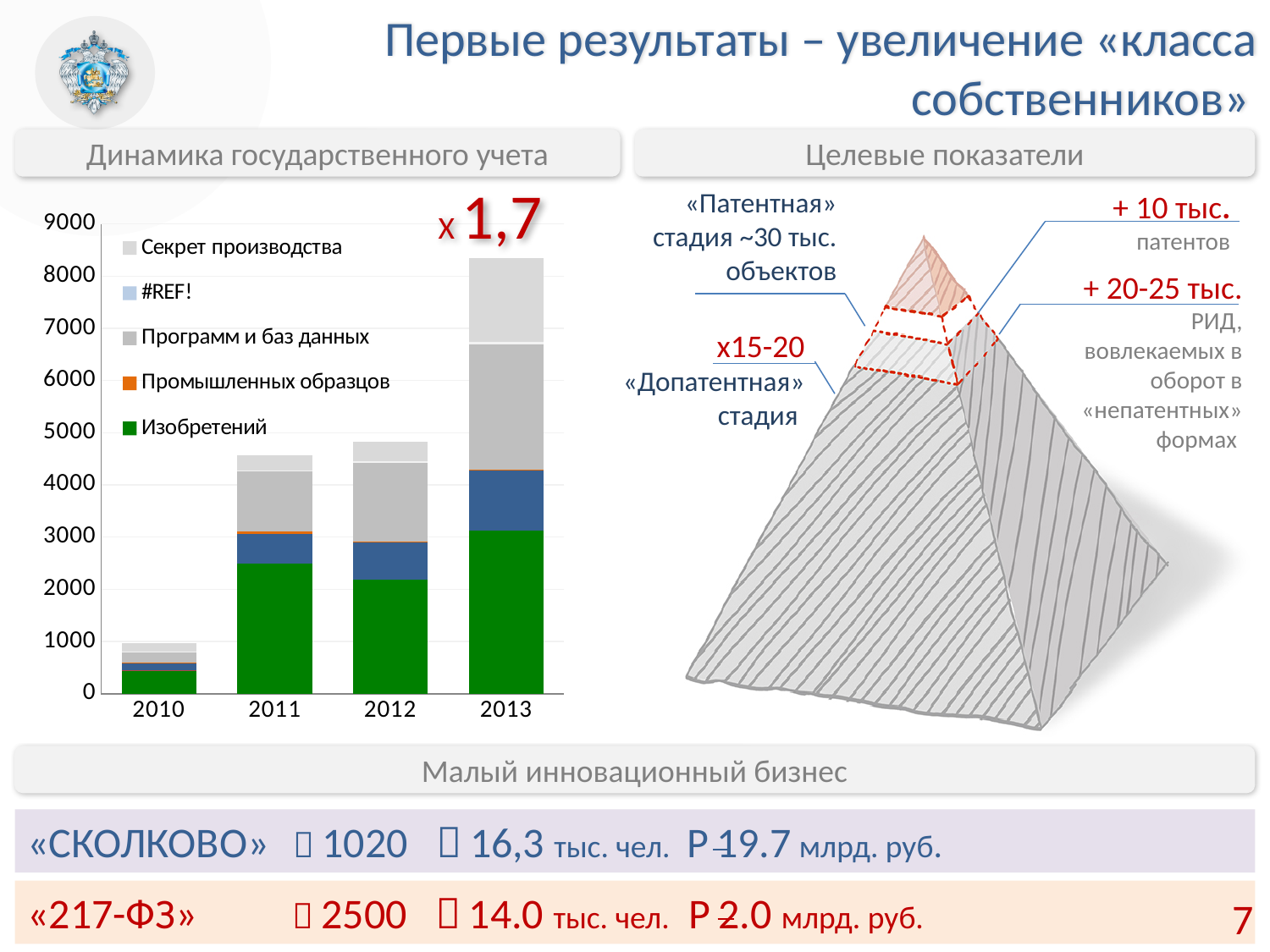
What kind of chart is shown under «Динамика государственного учета»? stacked bar chart Is the «Изобретений» segment for 2013 greater or less than 3000? greater How many series does the legend of the bar chart list? 5 Which year has the tallest stacked bar in the chart? 2013 Which year has the shortest stacked bar in the chart? 2010 What multiplier annotation is printed in red above the 2013 bar? x 1,7 How many years are shown on the x axis of the bar chart? 4 Is the total height of the 2013 bar greater or less than 8000? greater Which series is shown in green in the bar chart? Изобретений Which year has the larger «Изобретений» segment, 2011 or 2012? 2011 Do the total bar heights rise or fall from 2010 to 2013? rise